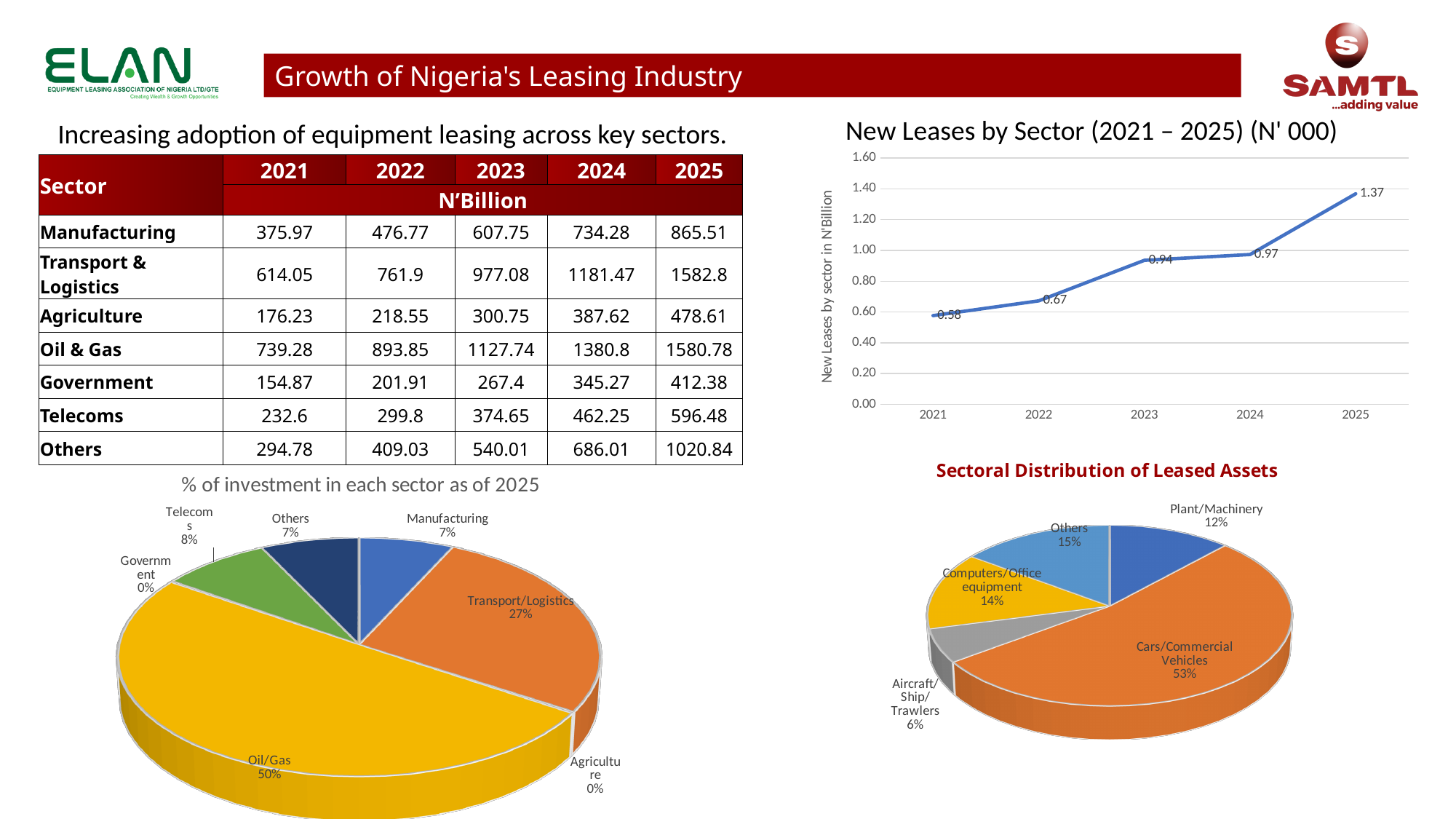
In the 'Sectoral Distribution of Leased Assets' pie chart, which is larger: Others or Computers/Office equipment? Others In the 'New Leases by Sector (2021 – 2025)' chart, what is the value for 2021? 0.58 In the '% of investment in each sector as of 2025' pie chart, what share does Oil/Gas have? 50% How many years are plotted in the 'New Leases by Sector (2021 – 2025)' chart? 5 In the 'New Leases by Sector (2021 – 2025)' chart, what is the difference between the 2025 and 2024 values? 0.40 In the 'Sectoral Distribution of Leased Assets' pie chart, what share do Cars/Commercial Vehicles have? 53% In the 'New Leases by Sector (2021 – 2025)' chart, what is the value for 2025? 1.37 What kind of chart is 'New Leases by Sector (2021 – 2025)'? line chart In the 'Sectoral Distribution of Leased Assets' pie chart, which category has the smallest share? Aircraft/Ship/Trawlers In the '% of investment in each sector as of 2025' pie chart, what is the share for Transport/Logistics? 27% In the 'New Leases by Sector (2021 – 2025)' chart, do the values rise or fall from 2021 to 2025? rise In the '% of investment in each sector as of 2025' pie chart, which sector has the largest share? Oil/Gas